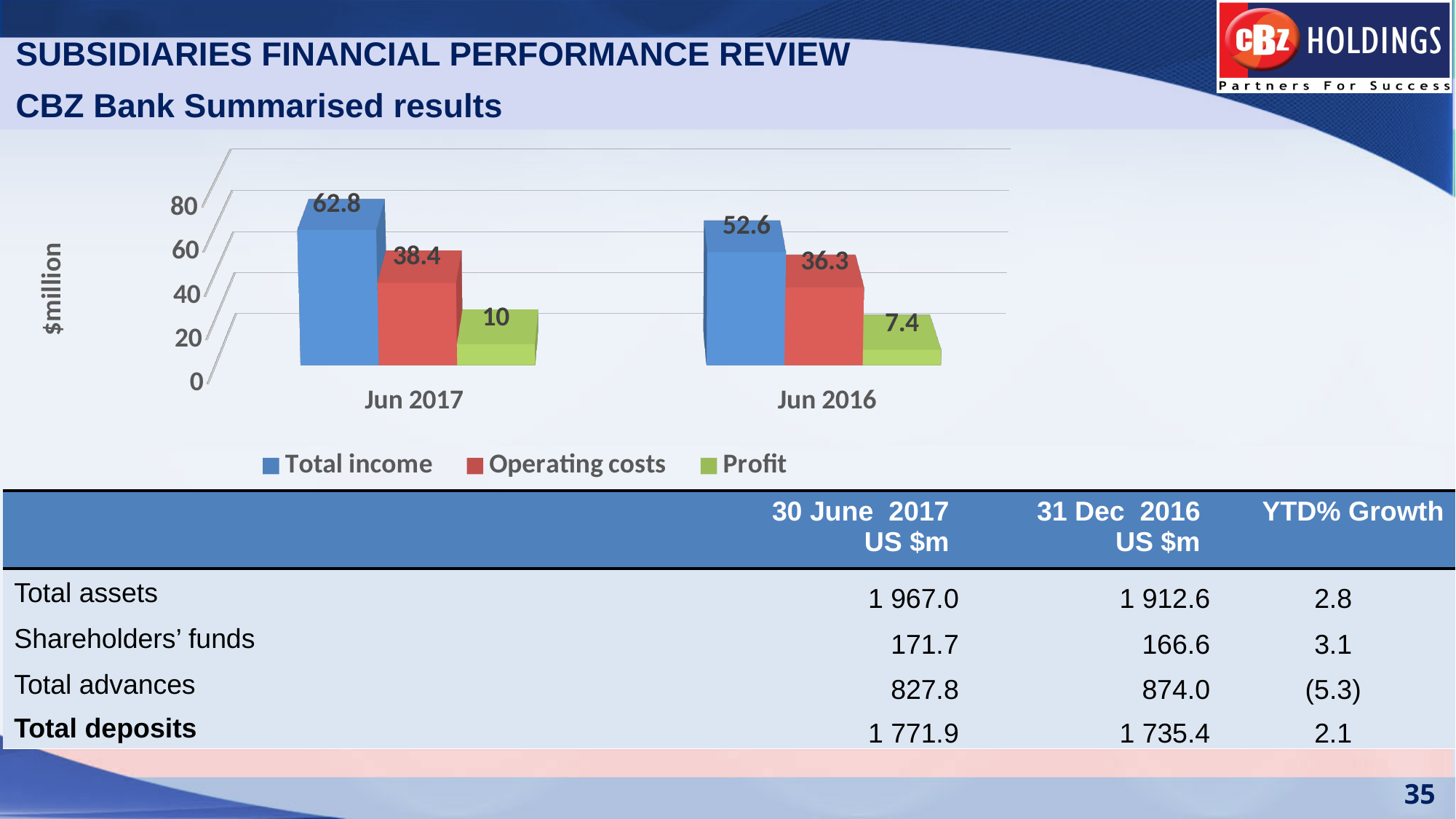
What is the Total income for Jun 2017? 62.8 Which period has the higher Total income? Jun 2017 Is the Total income for Jun 2016 greater or less than 40? greater Is the Profit for Jun 2016 larger or smaller than the Profit for Jun 2017? smaller What type of chart is shown on the slide? bar chart What is the difference in Total income between Jun 2017 and Jun 2016? 10.2 What is the Operating costs value for Jun 2016? 36.3 How many periods are shown on the x axis? 2 What is the difference between Total income and Operating costs in Jun 2017? 24.4 How many series does the legend list? 3 What is the Profit for Jun 2016? 7.4 What is the Profit for Jun 2017? 10